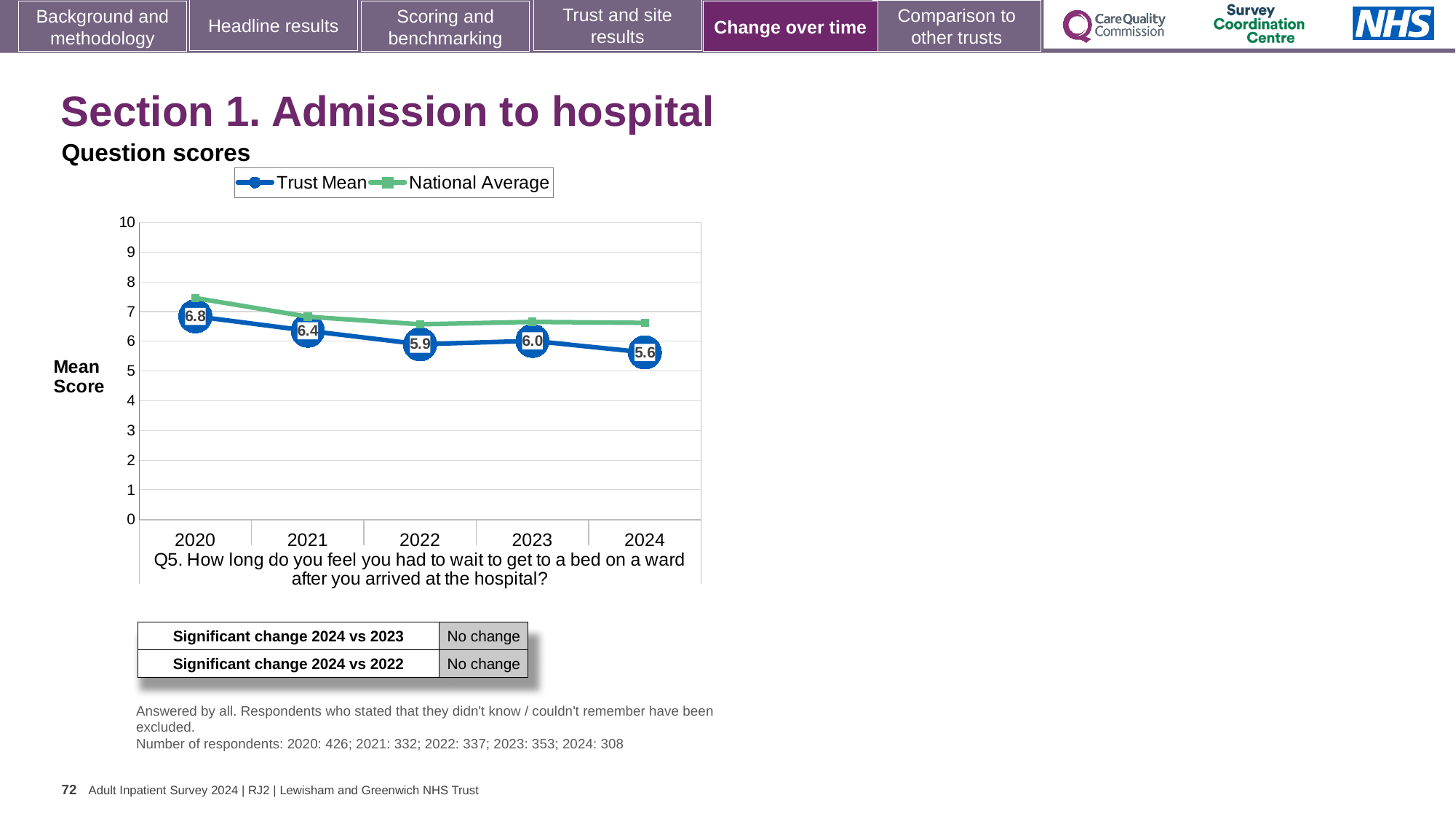
What is the Trust Mean value for 2020? 6.8 In which year is the Trust Mean lowest? 2024 What is the Trust Mean value for 2022? 5.9 Does the Trust Mean generally rise or fall from 2020 to 2024? Fall What is the Trust Mean value for 2024? 5.6 What kind of chart is shown on the slide? Line chart How many years are plotted on the x axis? 5 Is the National Average value for 2020 greater or less than 7? greater What is the difference between the Trust Mean in 2020 and in 2024? 1.2 Which year has the larger Trust Mean, 2022 or 2023? 2023 In which year is the Trust Mean highest? 2020 How many series does the legend list? 2